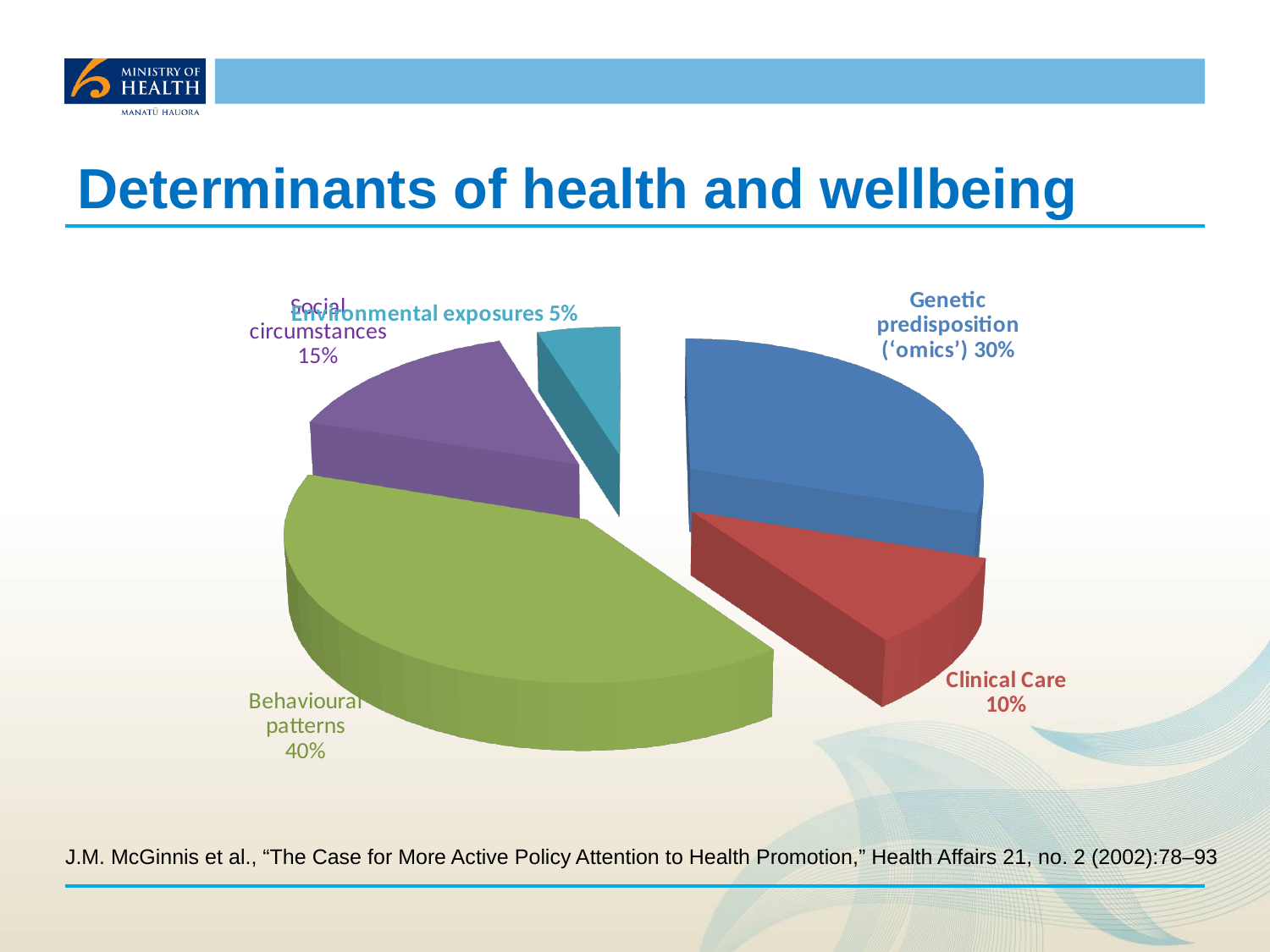
What share of the pie is Behavioural patterns? 40% Which slice of the pie is the largest? Behavioural patterns Which is larger, Social circumstances or Clinical Care? Social circumstances Which slice of the pie is the smallest? Environmental exposures What colour is the Clinical Care slice? Red What is the difference in percentage points between Behavioural patterns and Genetic predisposition ('omics')? 10 How many slices does the pie chart have? 5 What share of the pie is Social circumstances? 15% What share of the pie is Environmental exposures? 5% What kind of chart is shown on the slide? Pie chart